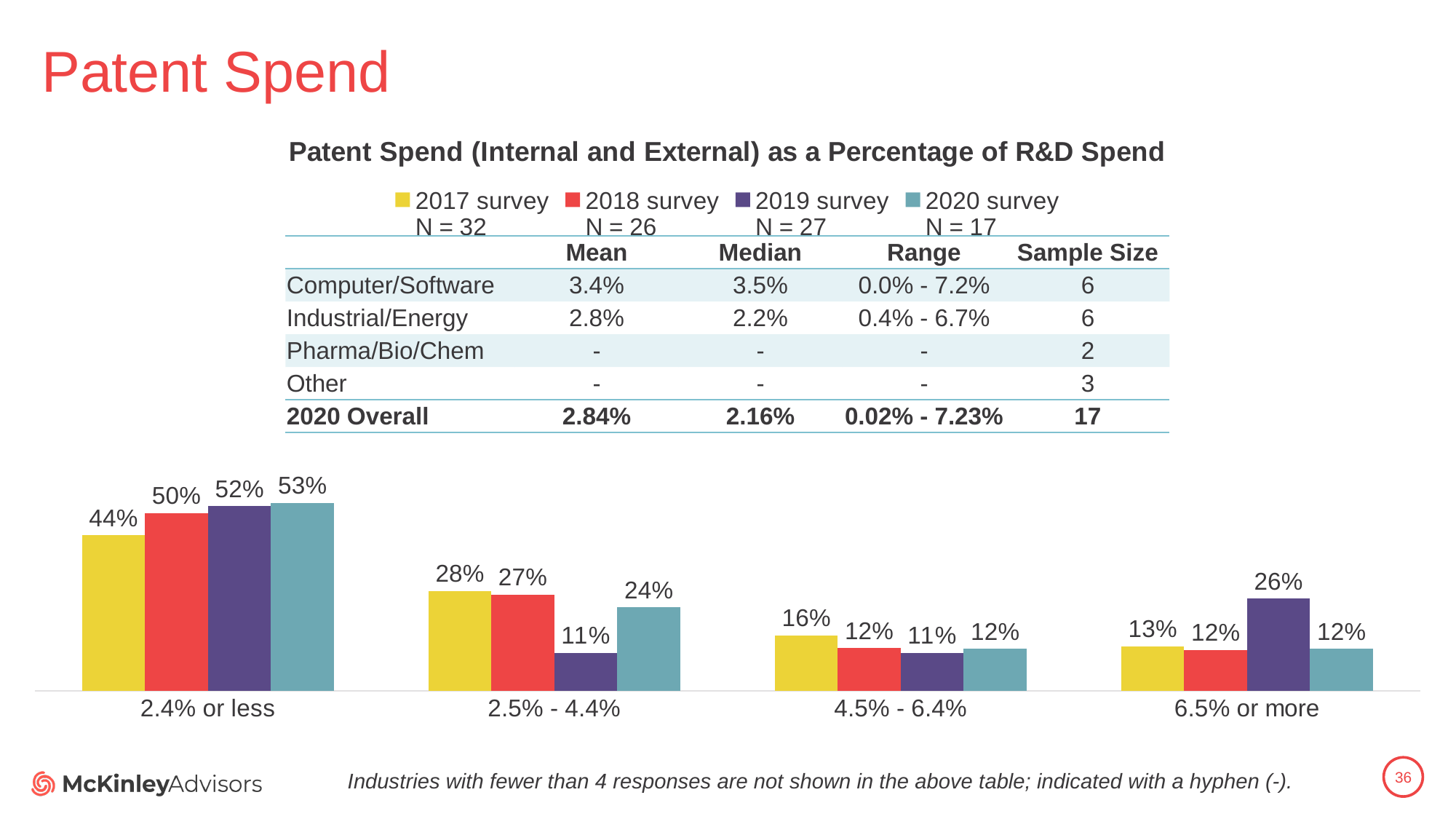
How many series does the chart legend list? 4 How many categories are shown on the x axis of the chart? 4 What kind of chart is shown on the slide? Bar chart What is the value for the 2019 survey in the '6.5% or more' category? 26% What is the value for the 2020 survey in the '2.4% or less' category? 53% What is the difference between the 2017 survey and 2020 survey values in the '2.4% or less' category? 9% What is the value for the 2017 survey in the '4.5% - 6.4%' category? 16% Which is larger in the '2.5% - 4.4%' category: the 2019 survey value or the 2020 survey value? 2020 survey Which category has the highest value for the 2018 survey? 2.4% or less Do the 2020 survey values rise or fall from '2.4% or less' to '4.5% - 6.4%'? Fall What is the sample size (N) for the 2020 survey shown in the legend? N = 17